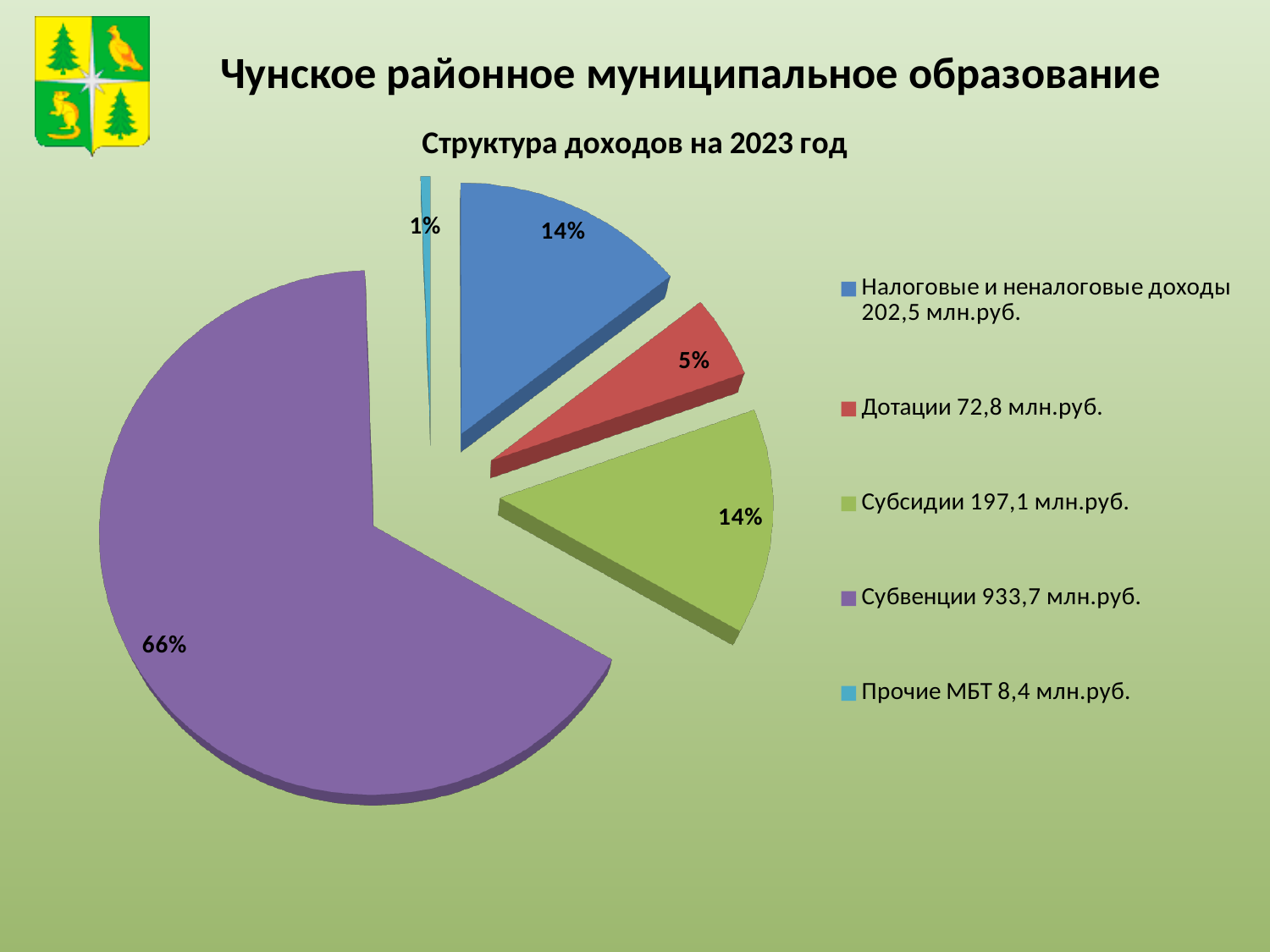
Which has a larger share of the pie, Дотации or Субсидии? Субсидии Which category has the smallest share of the pie? Прочие МБТ What share of the pie does Субвенции take? 66% What share of the pie does Дотации take? 5% Which category has the largest share of the pie? Субвенции What amount in млн.руб. does the legend give for Субвенции? 933,7 млн.руб. What share of the pie does Прочие МБТ take? 1% What kind of chart is shown on the slide? pie chart What amount in млн.руб. does the legend give for Налоговые и неналоговые доходы? 202,5 млн.руб. How many slices does the pie chart have? 5 What is the difference in percentage points between the Субвенции share and the Дотации share? 61 What is the title of the chart? Структура доходов на 2023 год